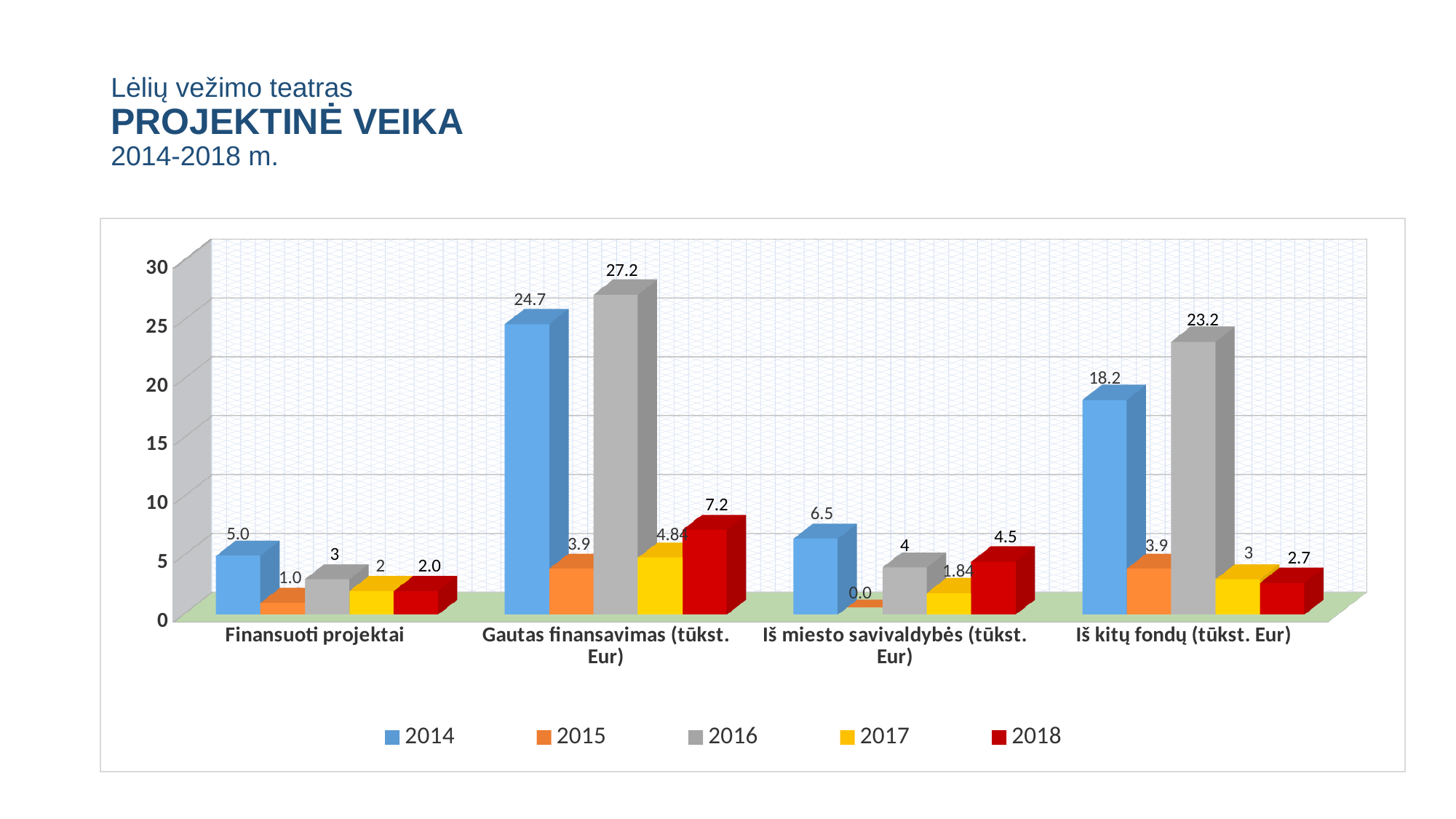
What is the difference between the 2016 and 2014 values in the "Iš kitų fondų (tūkst. Eur)" category? 5 Which year has the highest value in the "Gautas finansavimas (tūkst. Eur)" category? 2016 What is the value for 2017 in the "Iš miesto savivaldybės (tūkst. Eur)" category? 1.84 How many series does the legend list? 5 What kind of chart is shown on the slide? Bar chart What is the value for 2015 in the "Finansuoti projektai" category? 1.0 Which is larger in the "Gautas finansavimas (tūkst. Eur)" category: the 2018 value or the 2017 value? 2018 Which colour represents the 2018 series in the legend? Dark red How many categories are shown on the x axis? 4 What is the value for 2014 in the "Iš kitų fondų (tūkst. Eur)" category? 18.2 What is the value for 2016 in the "Gautas finansavimas (tūkst. Eur)" category? 27.2 Which year has the lowest value in the "Iš miesto savivaldybės (tūkst. Eur)" category? 2015